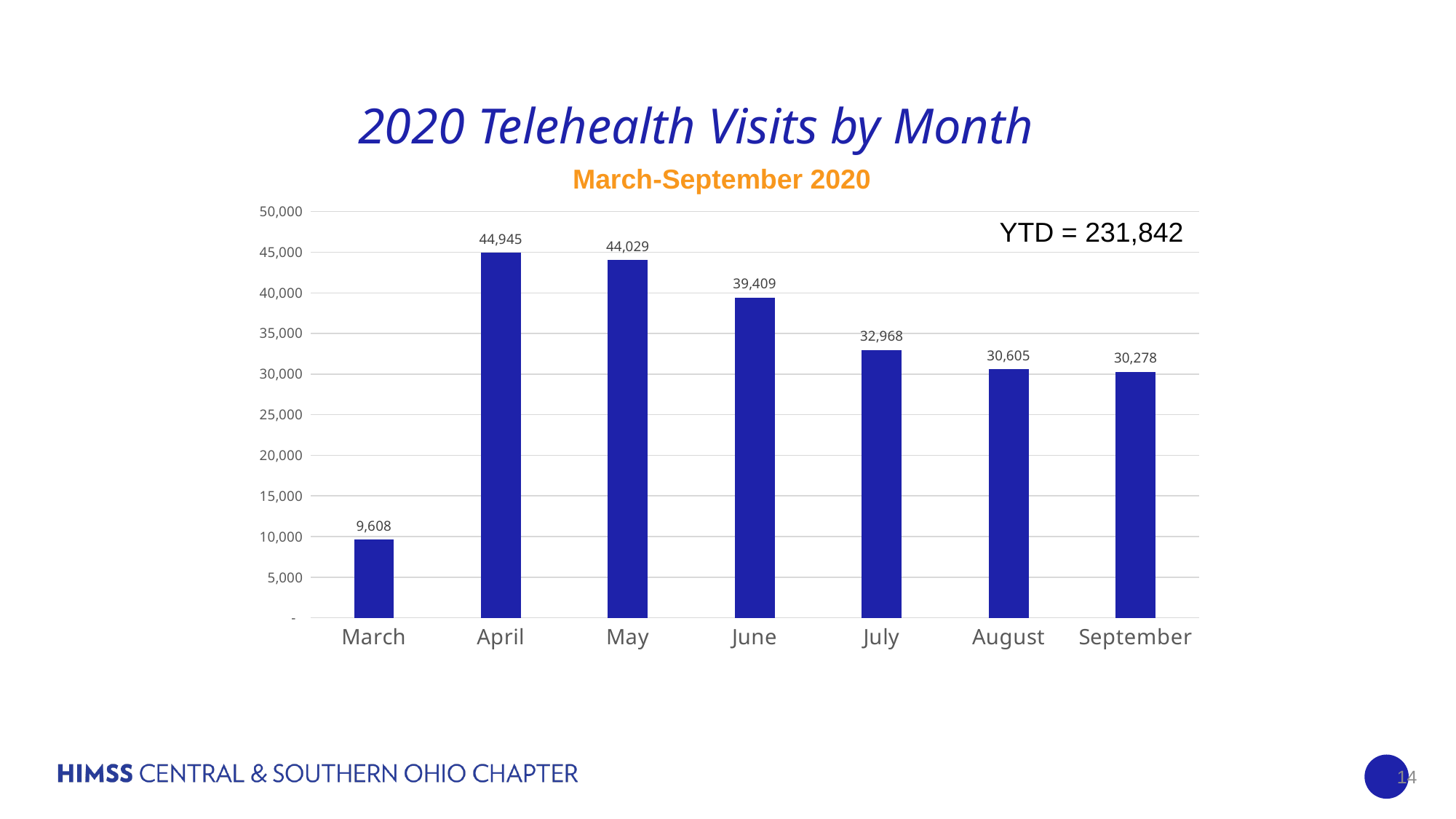
How many months are shown on the chart? 7 What kind of chart is shown on the slide? Bar chart What is the YTD total shown on the chart? 231,842 Which month has more telehealth visits, June or August? June What is the difference in telehealth visits between April and May? 916 Which month has the lowest number of telehealth visits? March Is the value for July greater or less than 30,000? greater What is the number of telehealth visits in April? 44,945 Which month has the highest number of telehealth visits? April What is the difference in telehealth visits between June and July? 6,441 What is the number of telehealth visits in March? 9,608 What is the number of telehealth visits in September? 30,278